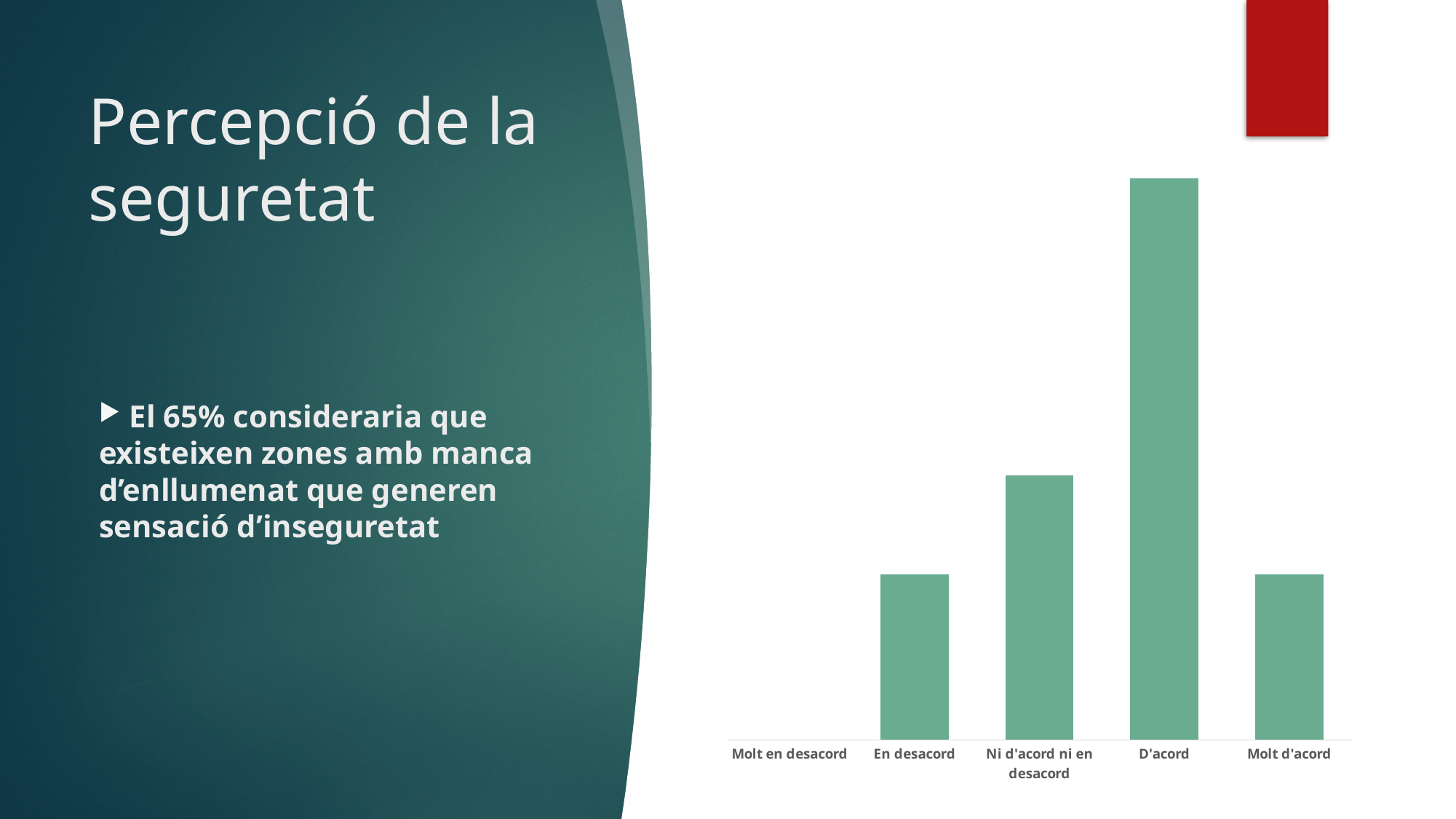
Which is larger, the value for En desacord or the value for Molt en desacord? En desacord What kind of chart is shown on the slide? bar chart How many categories are shown on the x axis of the chart? 5 What colour are the bars in the chart? green Which category has the highest bar in the chart? D'acord Which is larger, the value for D'acord or the value for Ni d'acord ni en desacord? D'acord Which is larger, the value for Ni d'acord ni en desacord or the value for Molt d'acord? Ni d'acord ni en desacord Which category has the second highest bar in the chart? Ni d'acord ni en desacord What is the label of the middle category on the x axis? Ni d'acord ni en desacord Which category has the lowest value in the chart? Molt en desacord